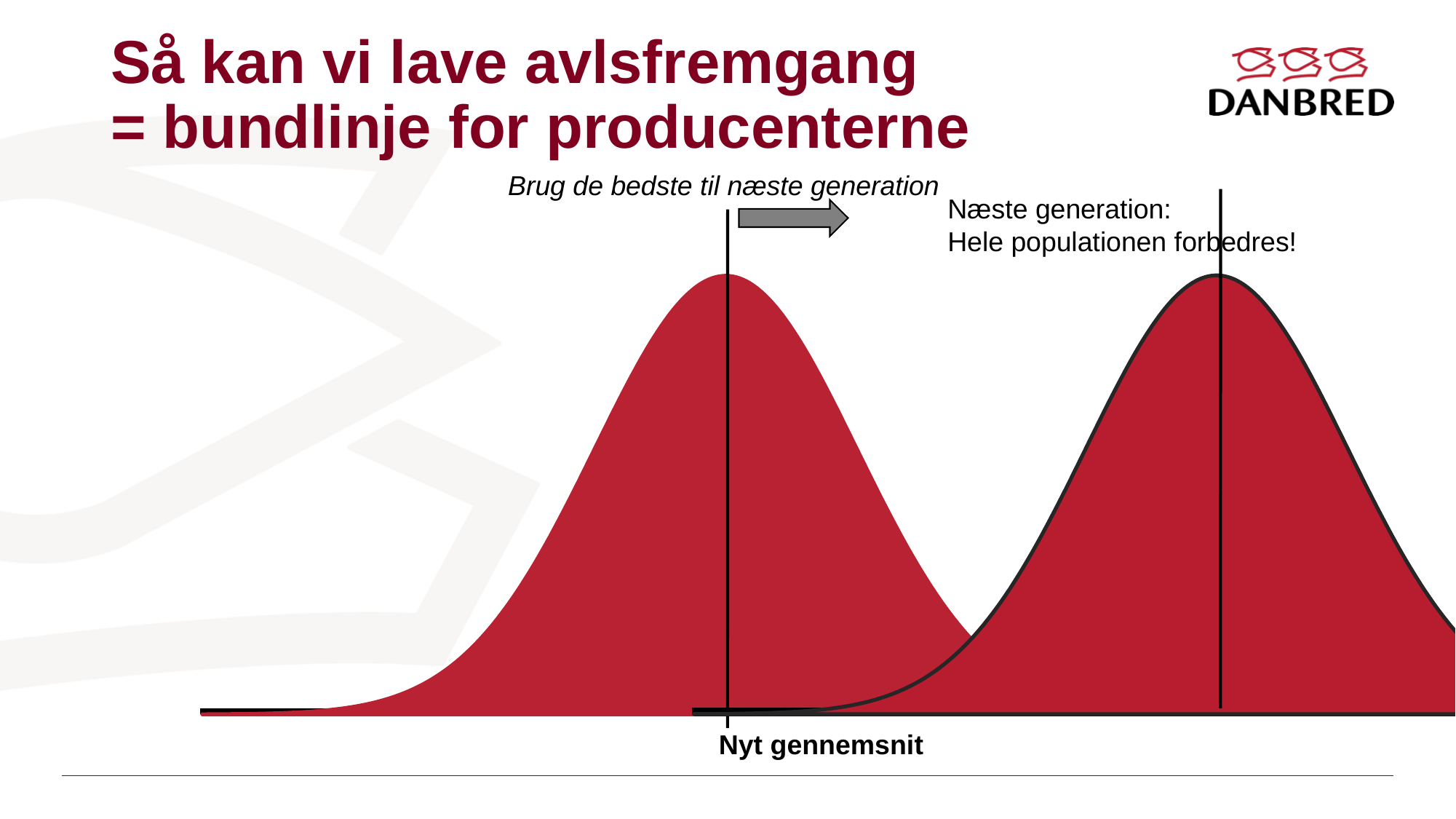
What text is written above the grey arrow between the two curves? Brug de bedste til næste generation How many bell-shaped curves are drawn on the slide? 2 What kind of chart is shown on the slide? Area chart (two bell curves) Which curve has its peak further to the right, the left curve or the right curve labelled 'Næste generation'? The right curve (Næste generation) What label is printed below the vertical line through the left curve? Nyt gennemsnit How many vertical lines mark the centres of the curves? 2